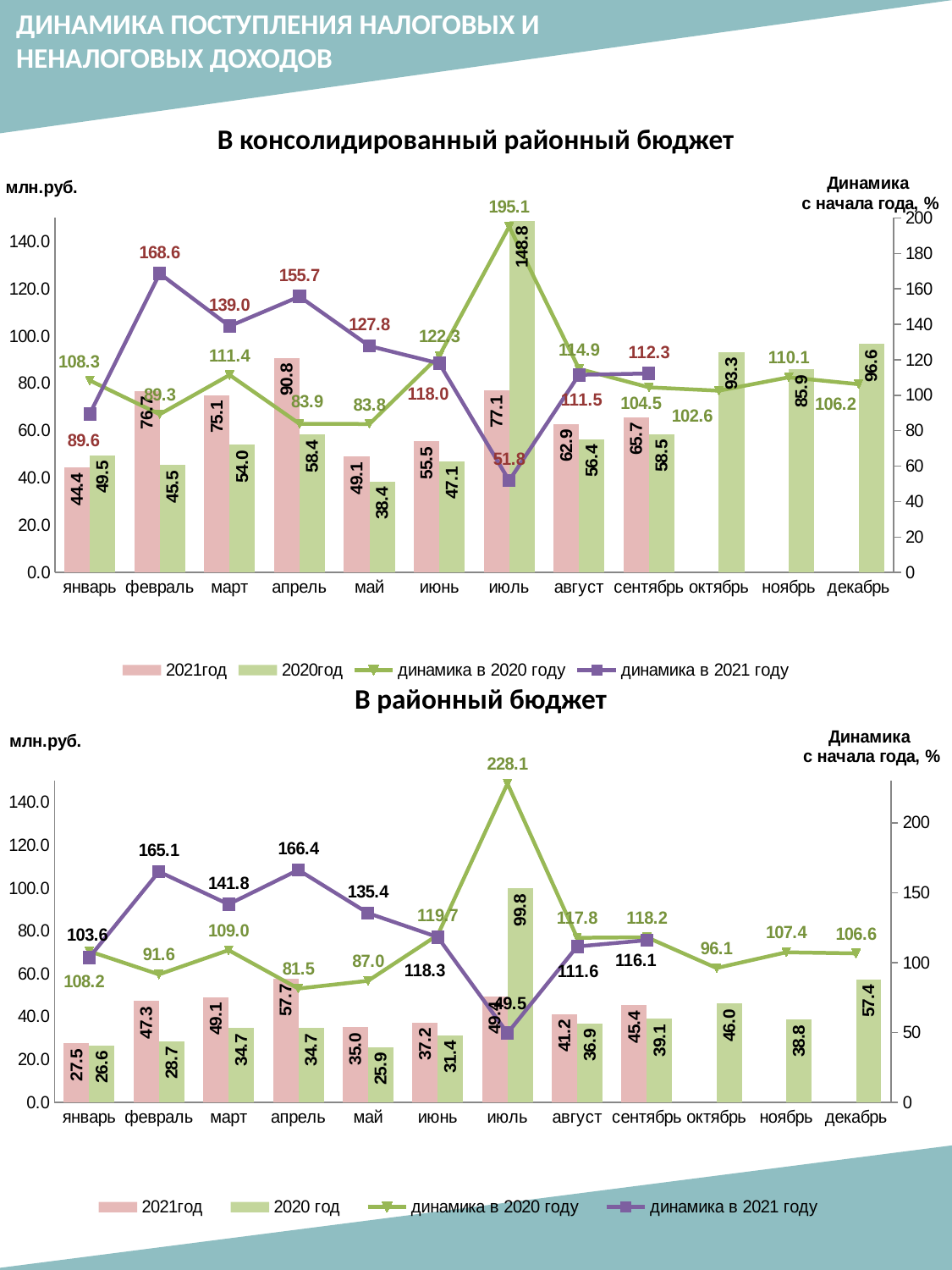
In the chart 'В консолидированный районный бюджет', what is the value of the 2021год bar for апрель? 90.8 What unit is shown on the left axis of the chart 'В районный бюджет'? млн.руб. In the chart 'В консолидированный районный бюджет', what is the difference between the 2021год and 2020год bars for февраль? 31.2 In the chart 'В консолидированный районный бюджет', which month has the highest value on the 'динамика в 2020 году' line? июль In the chart 'В районный бюджет', which is larger for май: the 2021год bar or the 2020 год bar? 2021год In the chart 'В районный бюджет', what is the highest value on the 'динамика в 2020 году' line? 228.1 In the chart 'В районный бюджет', what is the value of the 2020 год bar for декабрь? 57.4 In the chart 'В консолидированный районный бюджет', how many series does the legend list? 4 In the chart 'В районный бюджет', what is the value of the 'динамика в 2021 году' line for апрель? 166.4 In the chart 'В районный бюджет', how many months are shown on the x axis? 12 In the chart 'В консолидированный районный бюджет', what is the value of the 2020год bar for июль? 148.8 In the chart 'В консолидированный районный бюджет', which month has the lowest value on the 'динамика в 2021 году' line? июль